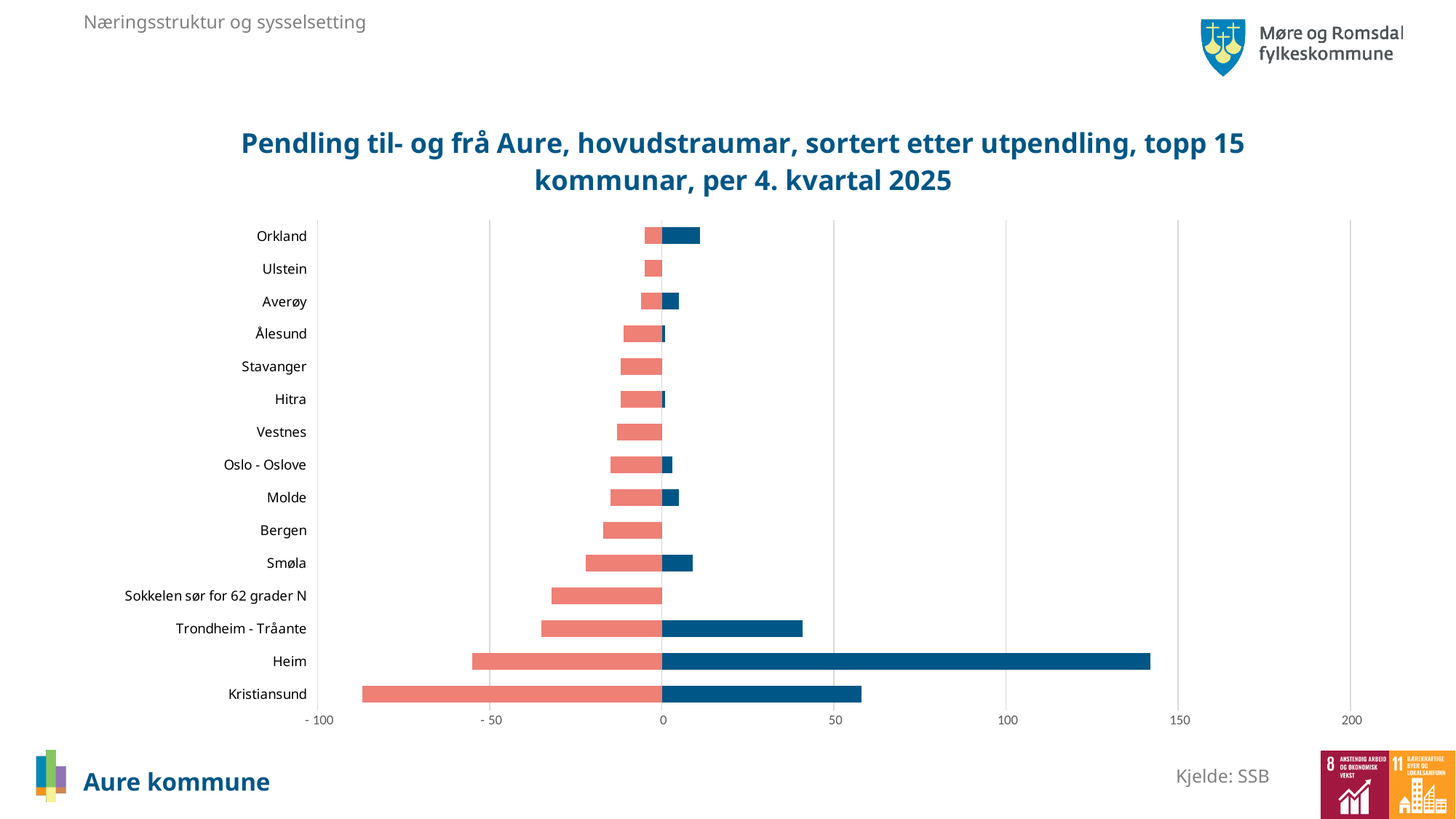
How many municipalities (categories) are listed on the vertical axis of the chart? 15 Which municipality has the longest red (negative) bar in the chart? Kristiansund What kind of chart is shown on the slide? bar chart Is the dark blue value for Heim greater or less than 100? greater Is the dark blue value for Kristiansund greater or less than 50? greater What is the title of the chart? Pendling til- og frå Aure, hovudstraumar, sortert etter utpendling, topp 15 kommunar, per 4. kvartal 2025 Which has the longer red bar, Smøla or Bergen? Smøla Which has the larger dark blue bar, Heim or Kristiansund? Heim Is the dark blue value for Trondheim - Tråante greater or less than 50? less Which municipality has the longest dark blue bar in the chart? Heim Which municipality is listed at the top of the chart? Orkland